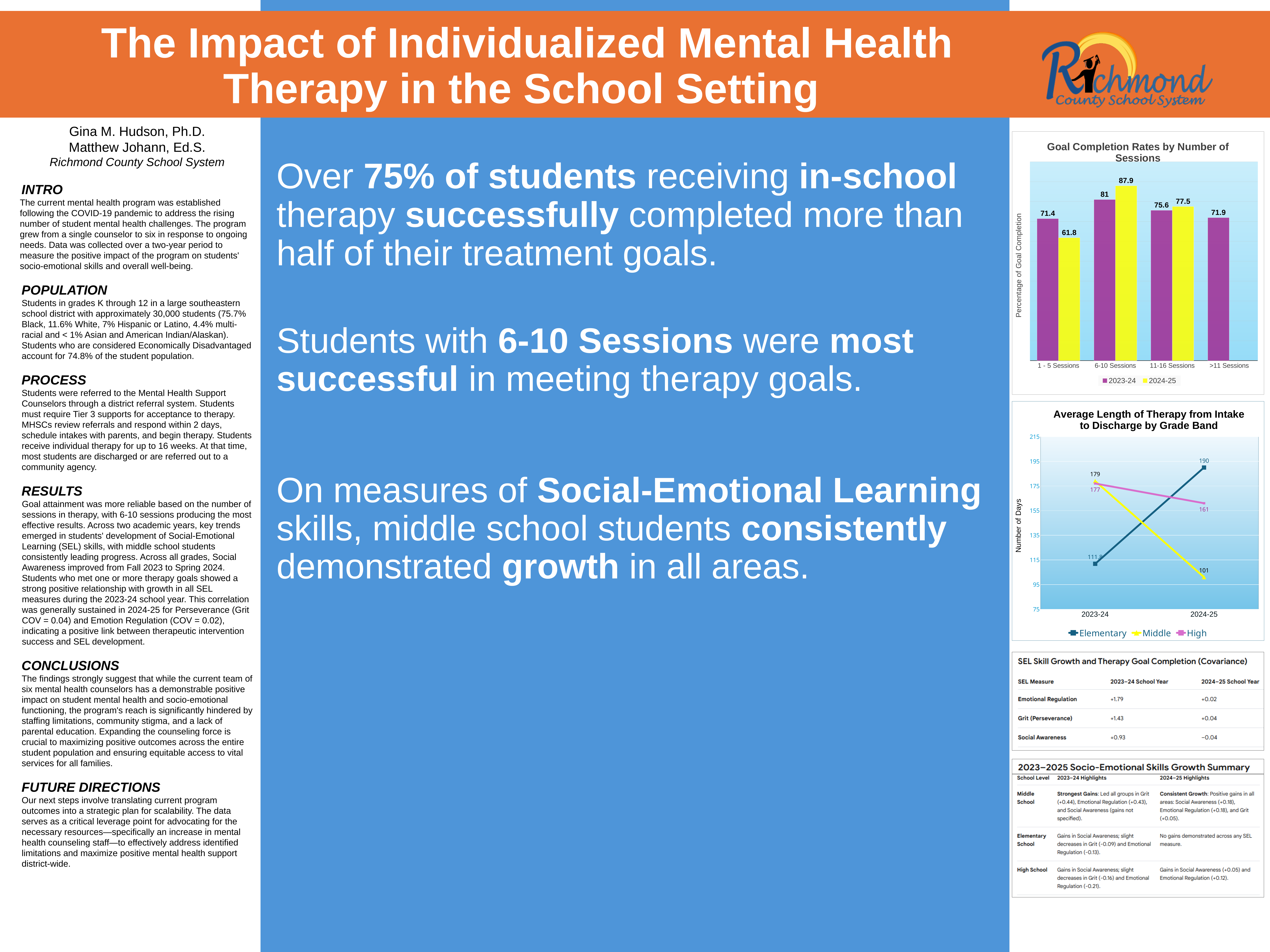
In the 'Goal Completion Rates by Number of Sessions' chart, which is larger for 1 - 5 Sessions: the 2023-24 value or the 2024-25 value? 2023-24 In the 'Average Length of Therapy from Intake to Discharge by Grade Band' chart, what is the difference between the High values for 2023-24 and 2024-25? 16 In the 'Average Length of Therapy from Intake to Discharge by Grade Band' chart, what is the Elementary value for 2024-25? 190 In the 'Average Length of Therapy from Intake to Discharge by Grade Band' chart, does the Middle series rise or fall from 2023-24 to 2024-25? Fall In the 'Goal Completion Rates by Number of Sessions' chart, what is the 2023-24 value for 1 - 5 Sessions? 71.4 In the 'Goal Completion Rates by Number of Sessions' chart, what is the difference between the 2024-25 and 2023-24 values for 6-10 Sessions? 6.9 In the 'Goal Completion Rates by Number of Sessions' chart, what is the 2024-25 value for 6-10 Sessions? 87.9 How many series does the legend of the 'Goal Completion Rates by Number of Sessions' chart list? 2 In the 'Goal Completion Rates by Number of Sessions' chart, which session category has the highest 2024-25 value? 6-10 Sessions What kind of chart is 'Goal Completion Rates by Number of Sessions'? Bar chart In the 'Average Length of Therapy from Intake to Discharge by Grade Band' chart, what is the Middle value for 2023-24? 179 In the 'Goal Completion Rates by Number of Sessions' chart, which session category has the lowest 2024-25 value? 1 - 5 Sessions